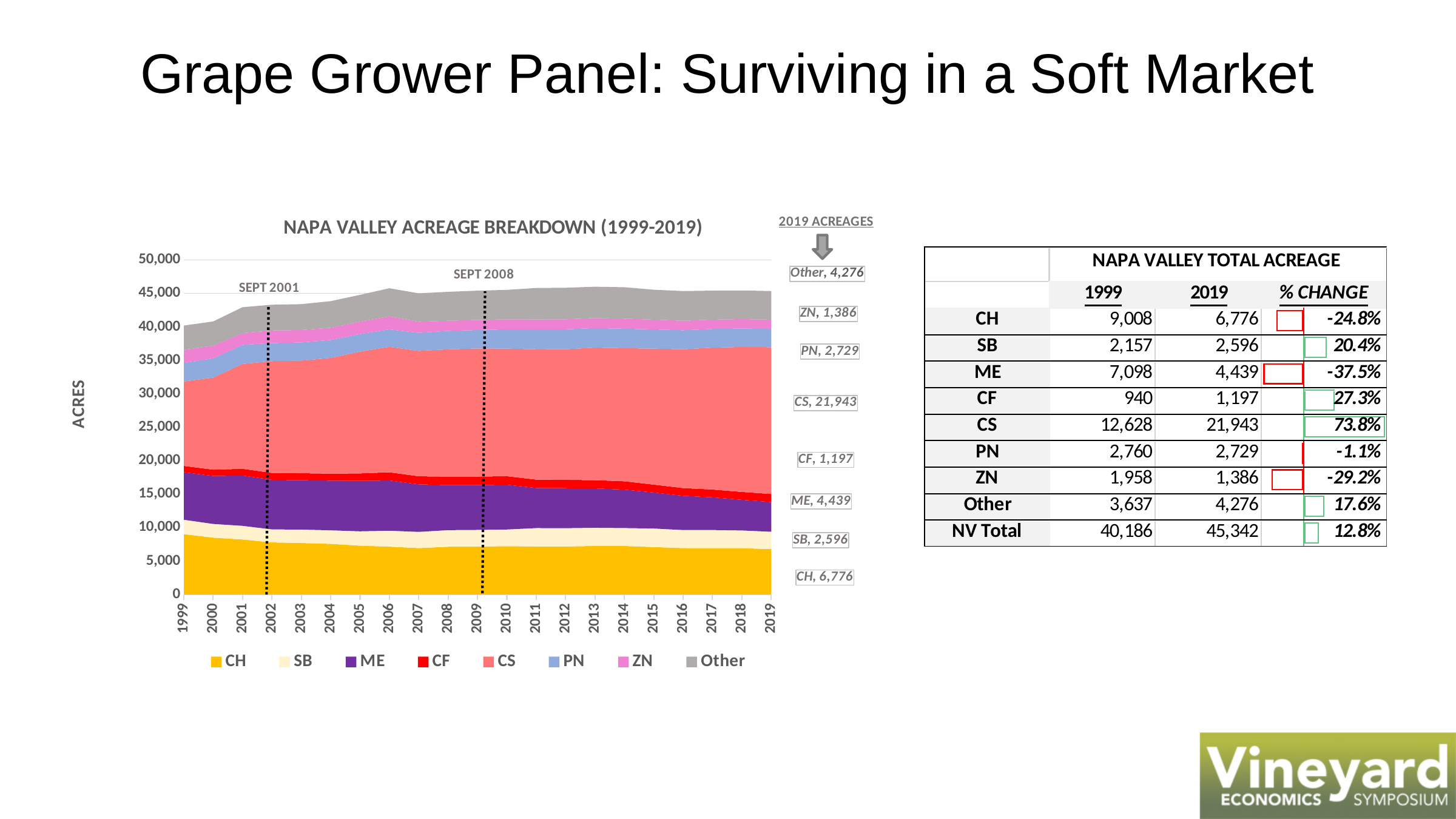
Is the total acreage shown on the chart for 1999 greater or less than 45,000? less What kind of chart is the Napa Valley Acreage Breakdown chart? Stacked area chart Which variety has the smallest acreage in 2019 on the chart? CF What is the difference between the 2019 acreage of CS and ME shown on the chart? 17,504 What is the total 2019 acreage across all varieties labelled on the chart? 45,342 Which variety has the largest acreage in 2019 on the chart? CS How many series does the legend of the Napa Valley Acreage Breakdown chart list? 8 How many years are shown along the x axis of the Napa Valley Acreage Breakdown chart? 21 According to the 2019 acreage labels on the chart, how many acres are planted to CH? 6,776 According to the 2019 acreage labels on the chart, how many acres are planted to CS? 21,943 Does the CS area on the chart generally rise or fall from 1999 to 2019? rise In 2019, which has more acreage on the chart, PN or SB? PN